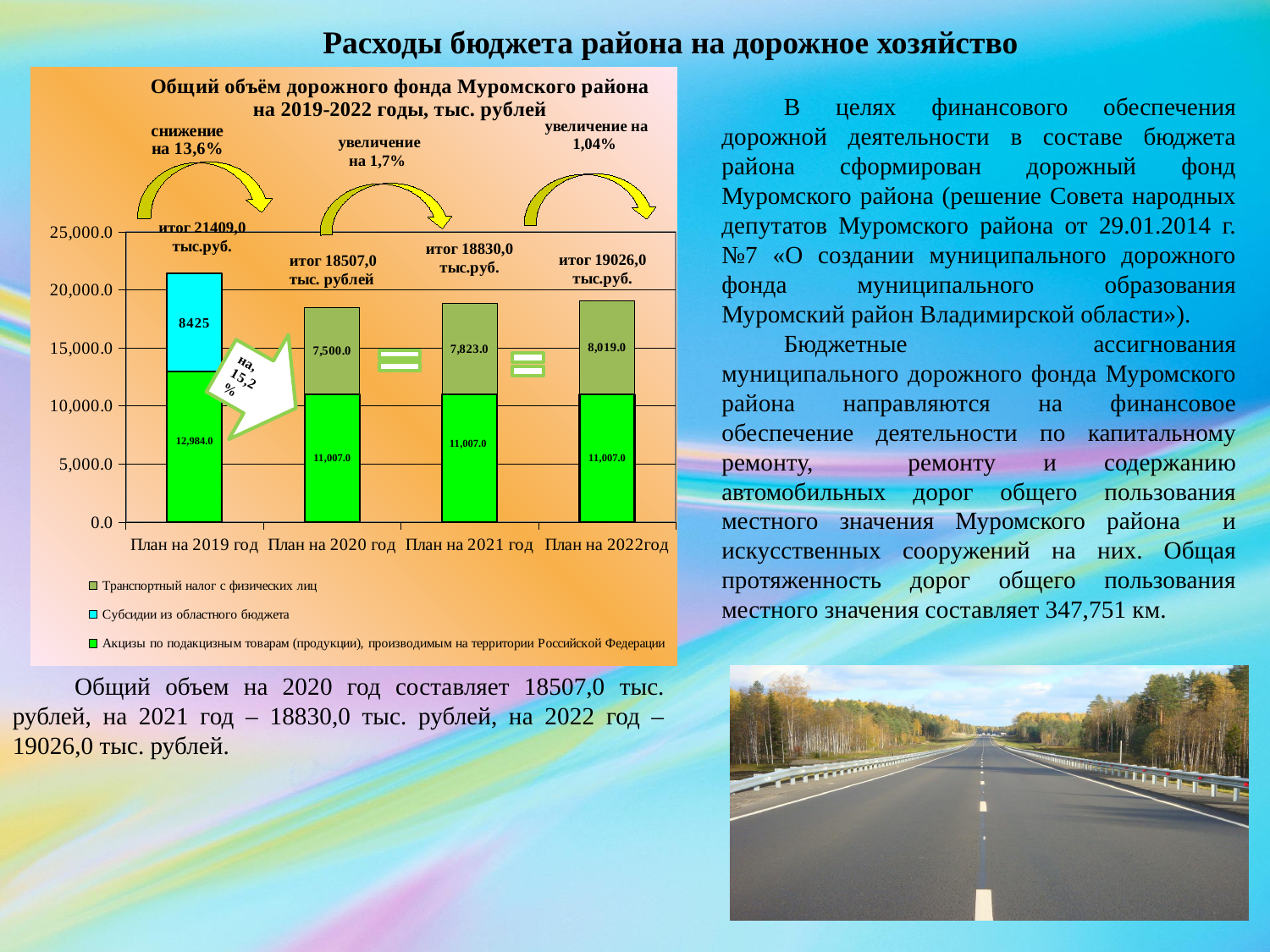
How many series does the legend list? 3 What is the value of Транспортный налог с физических лиц for План на 2021 год? 7,823.0 Which is larger: Акцизы for План на 2019 год or Акцизы for План на 2021 год? План на 2019 год Which year has the highest total road fund? План на 2019 год What is the total (итог) of the stacked bar for План на 2020 год? 18507,0 тыс. рублей What is the value of Субсидии из областного бюджета for План на 2019 год? 8425 What is the difference between Транспортный налог for План на 2022 год and План на 2020 год? 519.0 How many categories (years) are plotted on the x axis? 4 What is the value of Акцизы по подакцизным товарам for План на 2019 год? 12,984.0 What kind of chart is shown on the slide? stacked bar chart Which year has the lowest total road fund? План на 2020 год What is the value of Транспортный налог с физических лиц for План на 2022 год? 8,019.0